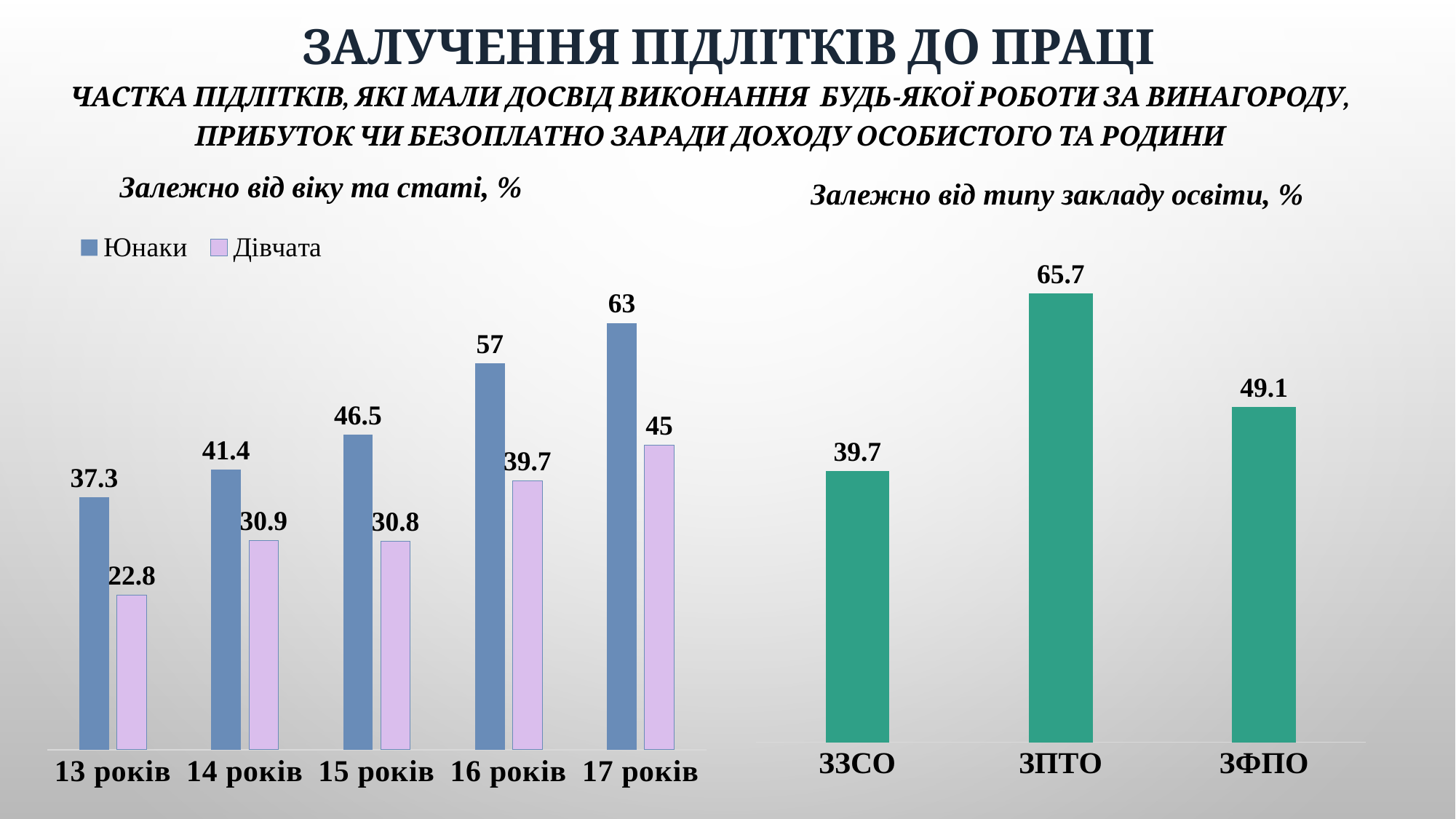
In the right chart (Залежно від типу закладу освіти, %), which category has the highest value? ЗПТО In the left chart (Залежно від віку та статі, %), what is the difference between Юнаки and Дівчата at 17 років? 18 In the left chart (Залежно від віку та статі, %), what is the value for Дівчата at 13 років? 22.8 In the right chart (Залежно від типу закладу освіти, %), what is the difference between ЗПТО and ЗЗСО? 26 In the left chart (Залежно від віку та статі, %), which age group has the lowest value for Дівчата? 13 років In the right chart (Залежно від типу закладу освіти, %), what is the value for ЗФПО? 49.1 In the left chart (Залежно від віку та статі, %), which is larger: Дівчата at 14 років or Дівчата at 15 років? Дівчата at 14 років How many series does the legend of the left chart (Залежно від віку та статі, %) list? 2 What type of chart is the right chart (Залежно від типу закладу освіти, %)? bar chart In the left chart (Залежно від віку та статі, %), do the values for Юнаки rise or fall as age increases from 13 to 17 років? rise How many age categories are shown in the left chart (Залежно від віку та статі, %)? 5 In the left chart (Залежно від віку та статі, %), what is the value for Юнаки at 15 років? 46.5